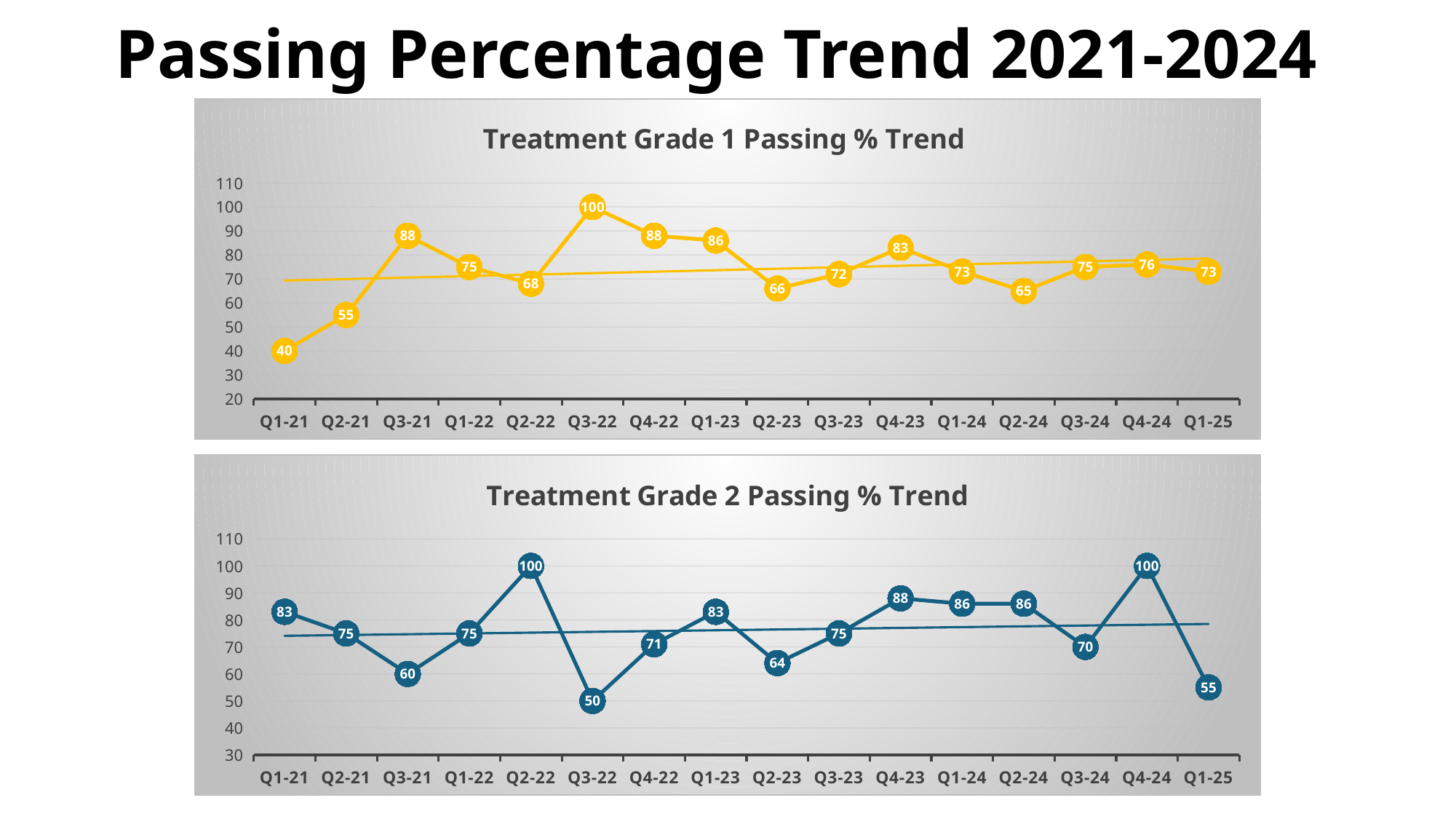
In the Treatment Grade 2 Passing % Trend chart, what is the value for Q4-22? 71 How many quarters are plotted in the Treatment Grade 2 Passing % Trend chart? 16 In the Treatment Grade 1 Passing % Trend chart, do the values rise or fall from Q1-21 to Q3-21? rise In the Treatment Grade 2 Passing % Trend chart, which quarter has the lowest value? Q3-22 In the Treatment Grade 1 Passing % Trend chart, which quarter has the highest value? Q3-22 In the Treatment Grade 1 Passing % Trend chart, what is the difference between the values for Q3-22 and Q2-23? 34 In the Treatment Grade 2 Passing % Trend chart, what is the difference between the values for Q4-24 and Q1-25? 45 In the Treatment Grade 2 Passing % Trend chart, which is larger, the value for Q1-21 or the value for Q3-21? Q1-21 What kind of chart is the Treatment Grade 1 Passing % Trend chart? line chart In the Treatment Grade 1 Passing % Trend chart, is the value for Q2-21 greater or less than 60? less In the Treatment Grade 1 Passing % Trend chart, what is the value for Q3-21? 88 In the Treatment Grade 1 Passing % Trend chart, which quarter has the lowest value? Q1-21